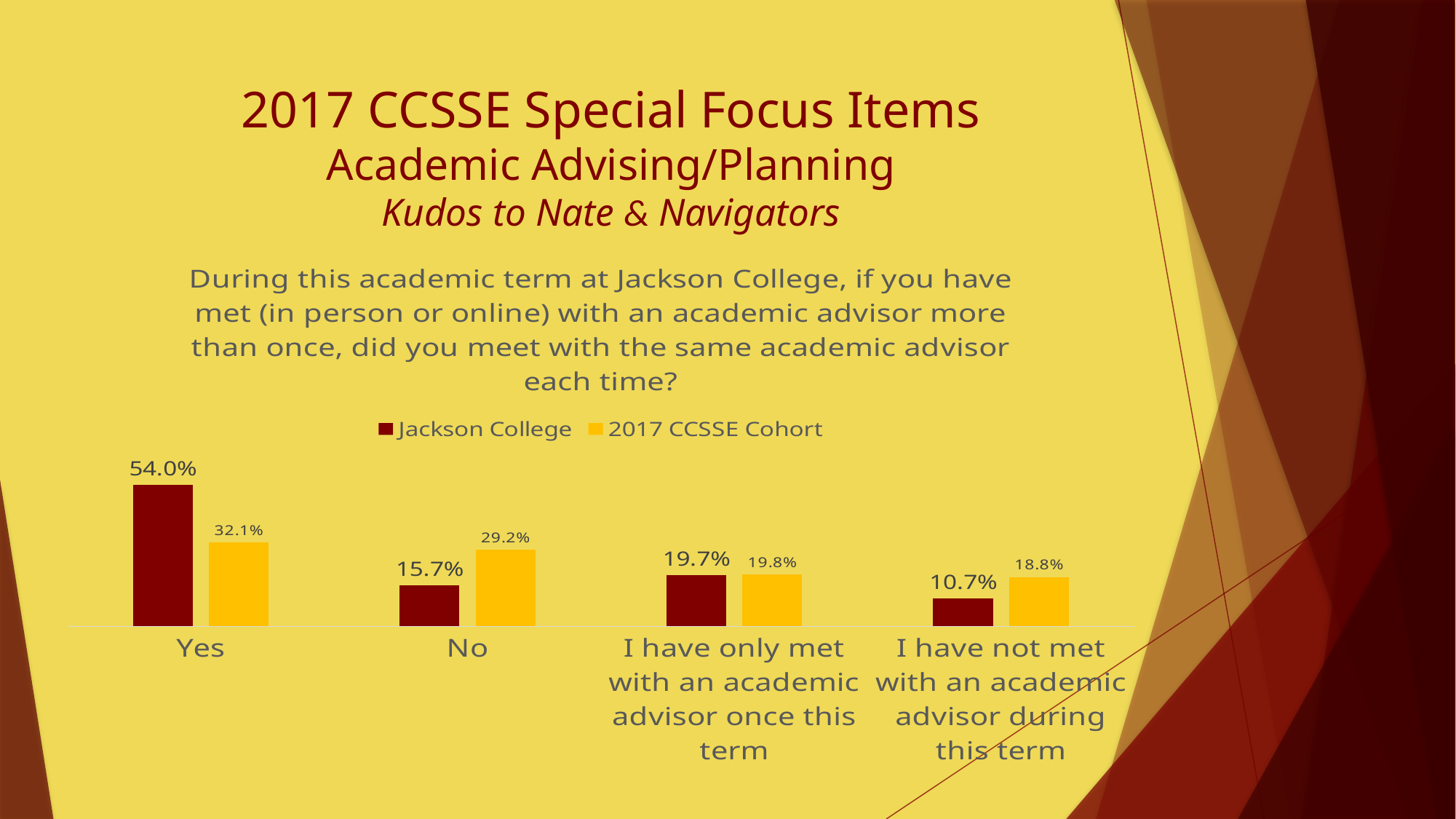
Which colour represents Jackson College in the chart? Dark red What is the 2017 CCSSE Cohort value for "I have only met with an academic advisor once this term"? 19.8% What is the 2017 CCSSE Cohort value for "No"? 29.2% For "No", which series has the larger value, Jackson College or 2017 CCSSE Cohort? 2017 CCSSE Cohort What kind of chart is shown on the slide? Bar chart What is the Jackson College value for "Yes"? 54.0% Which category has the highest Jackson College value? Yes How many series does the legend list? 2 What is the Jackson College value for "I have not met with an academic advisor during this term"? 10.7% How many categories are shown on the x axis? 4 What is the difference between the Jackson College and 2017 CCSSE Cohort values for "Yes"? 21.9% Which category has the lowest 2017 CCSSE Cohort value? I have not met with an academic advisor during this term